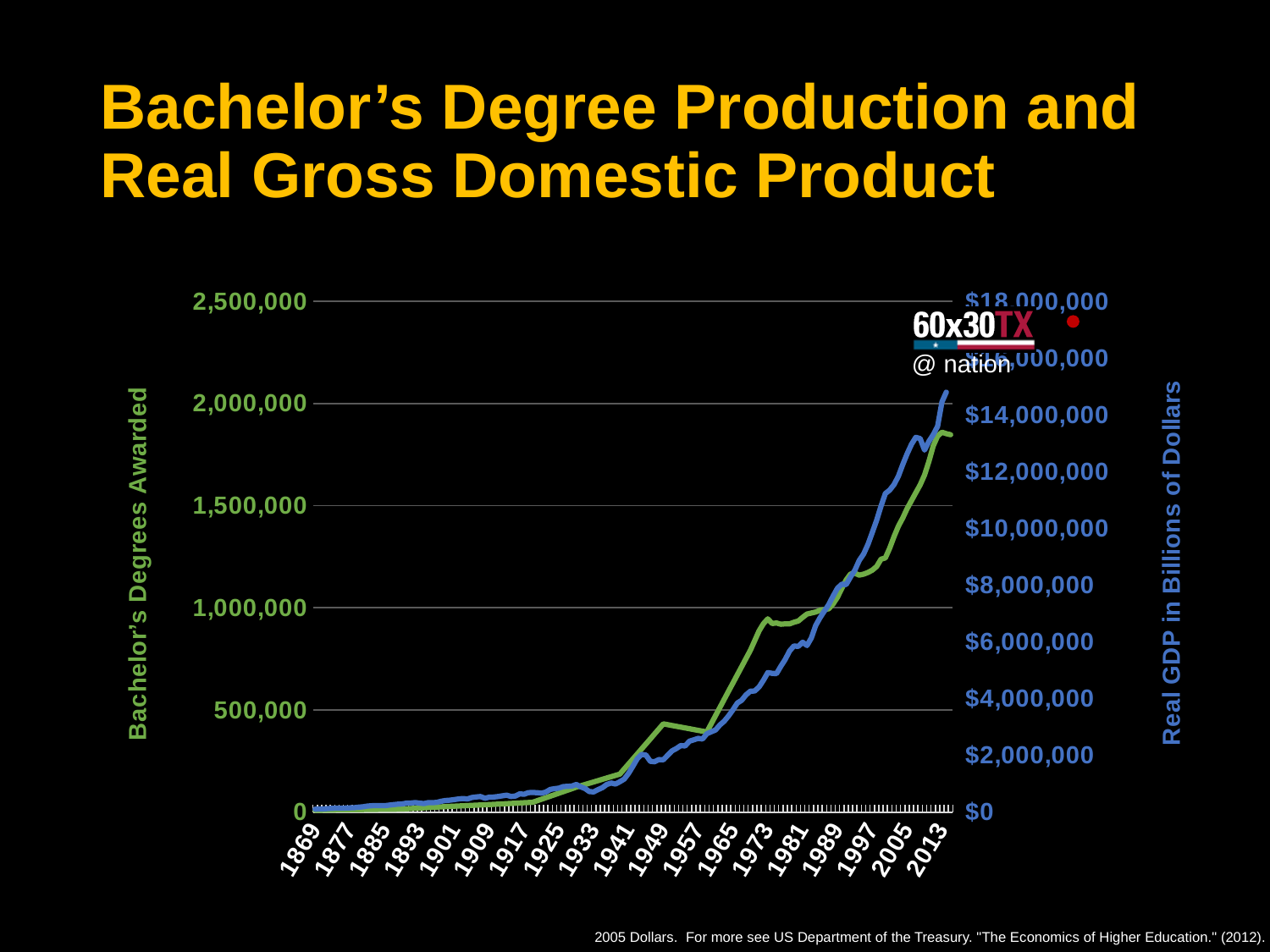
What is the title of the chart on the slide? Bachelor's Degree Production and Real Gross Domestic Product Is the value for Real GDP in 2013 greater or less than $14,000,000? greater What does the left vertical axis of the chart measure? Bachelor's Degrees Awarded Do the values for Real GDP generally rise or fall across the years shown? rise Do the values for Bachelor's Degrees Awarded generally rise or fall from 1869 to 2013? rise What kind of chart is shown on the slide? line chart In which year shown on the x axis is the value for Bachelor's Degrees Awarded highest? 2013 How many data series (lines) are plotted on the chart? 2 Is the value for Bachelor's Degrees Awarded in 1949 greater or less than 500,000? less Is the value for Bachelor's Degrees Awarded in 1973 greater or less than 1,000,000? less